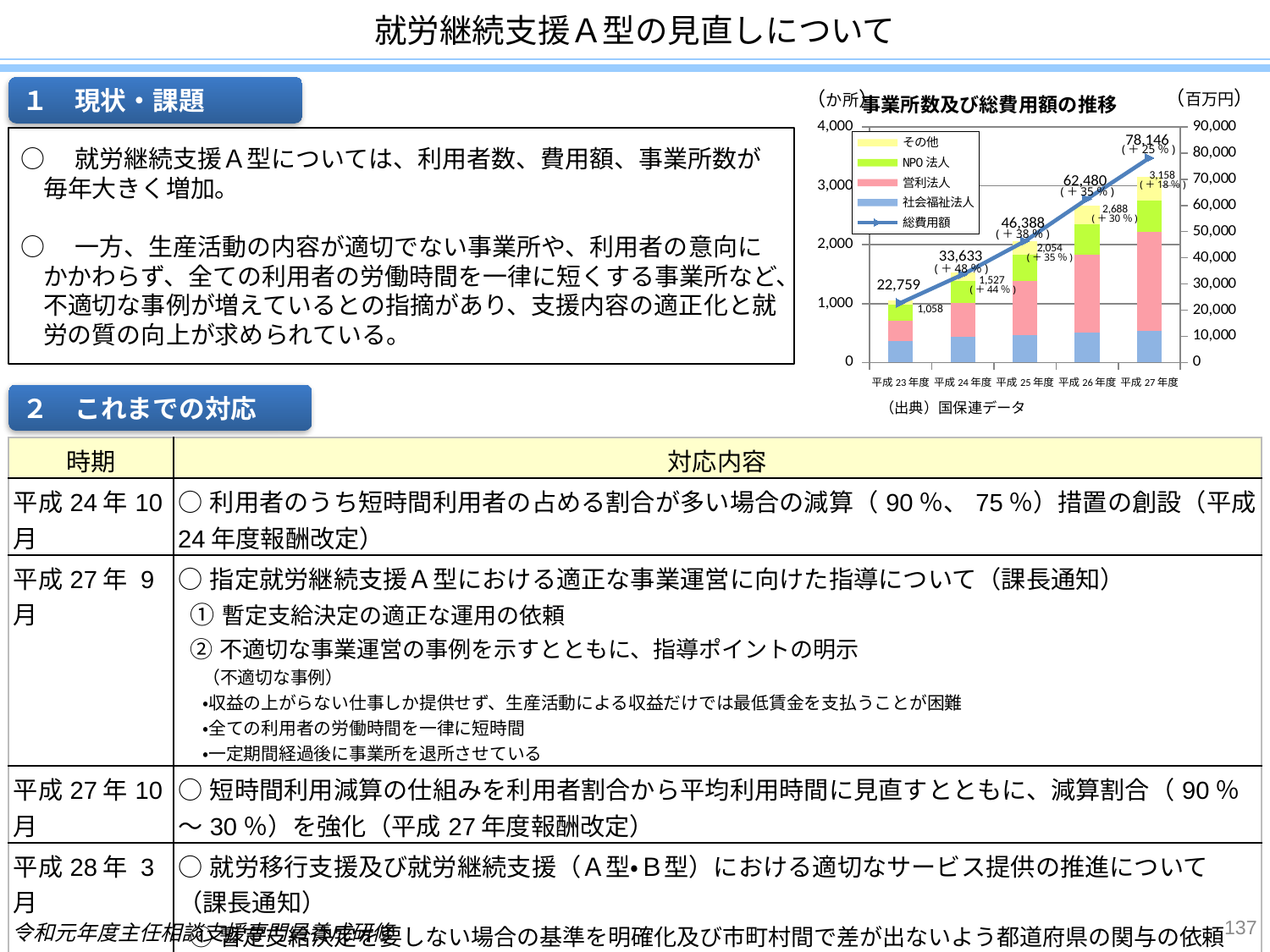
What percentage increase is shown next to the 総費用額 value for 平成24年度? +48% What is the difference in 総費用額 between 平成27年度 and 平成26年度? 15,666 How many fiscal years are shown on the x axis of the chart? 5 Which fiscal year has the lowest total number of 事業所? 平成23年度 What is the value of 総費用額 for 平成27年度 in the chart 事業所数及び総費用額の推移? 78,146 What is the total number of 事業所 (bar total) for 平成23年度? 1,058 What is the difference in the total number of 事業所 between 平成25年度 and 平成24年度? 527 Which fiscal year has the highest 総費用額? 平成27年度 How many entries does the chart legend list? 5 What is the overall trend of 総費用額 from 平成23年度 to 平成27年度? Rising Is the 社会福祉法人 segment of the 平成27年度 bar greater or less than 1,000? less Is the 総費用額 for 平成26年度 larger than that for 平成25年度? Yes, 平成26年度 (62,480) is larger